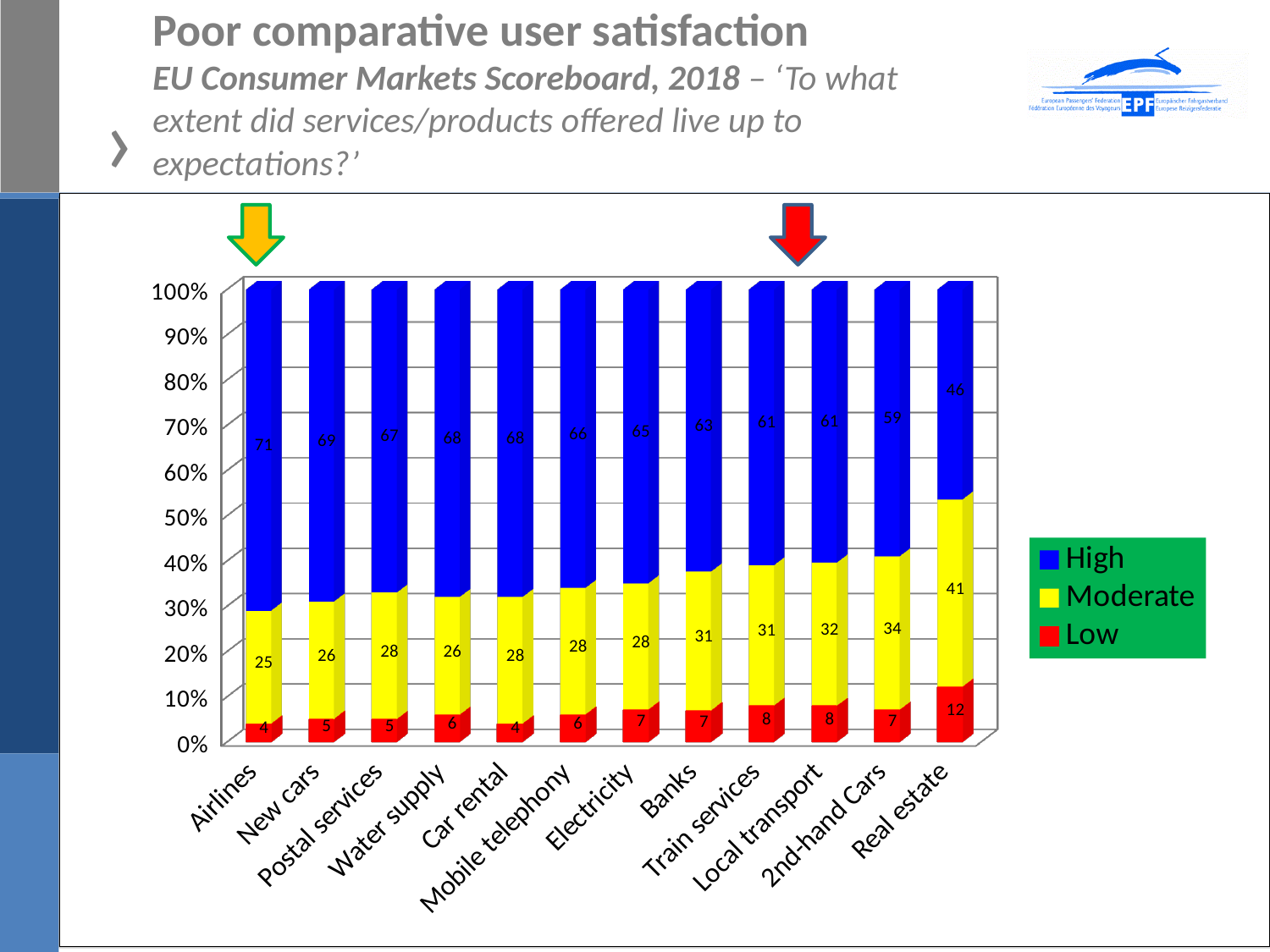
Which category has the lowest 'High' value? Real estate Which colour represents the 'Low' series in the legend? Red Do the 'High' values generally rise or fall moving from Airlines to Real estate along the x axis? Fall Which category has the highest 'High' value? Airlines What is the 'Low' value for Real estate? 12 What kind of chart is shown on the slide? Stacked bar chart How many categories are shown on the x axis? 12 What is the difference between the 'High' value for Airlines and the 'High' value for Real estate? 25 What is the 'High' value for Train services? 61 What is the 'Moderate' value for Airlines? 25 How many series does the legend list? 3 Which is larger, the 'Moderate' value for 2nd-hand Cars or the 'Moderate' value for Banks? 2nd-hand Cars